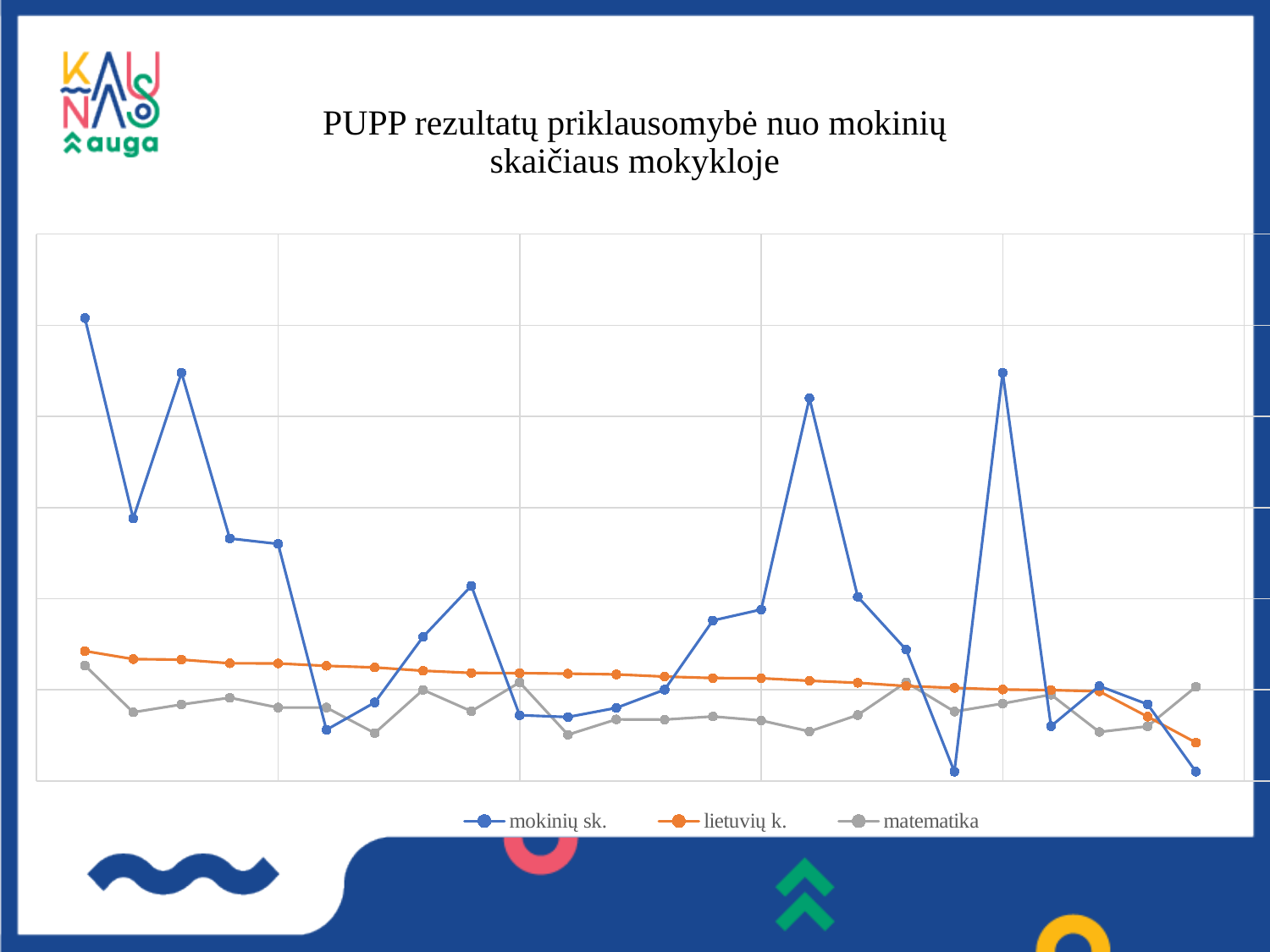
Does the lietuvių k. line rise or fall from left to right along the x axis? fall At the first (leftmost) point, which is larger: mokinių sk. or lietuvių k.? mokinių sk. Overall, does the mokinių sk. line end lower or higher than it starts? lower Which series is shown in orange in the legend? lietuvių k. Which series has the lowest value at the last (rightmost) point? mokinių sk. How many series does the legend list? 3 What kind of chart is shown on the slide? line chart How many data points does each line have? 24 Which series has the highest value at the last (rightmost) point? matematika Which series has the highest value at the first (leftmost) point? mokinių sk. What is the title of the chart? PUPP rezultatų priklausomybė nuo mokinių skaičiaus mokykloje